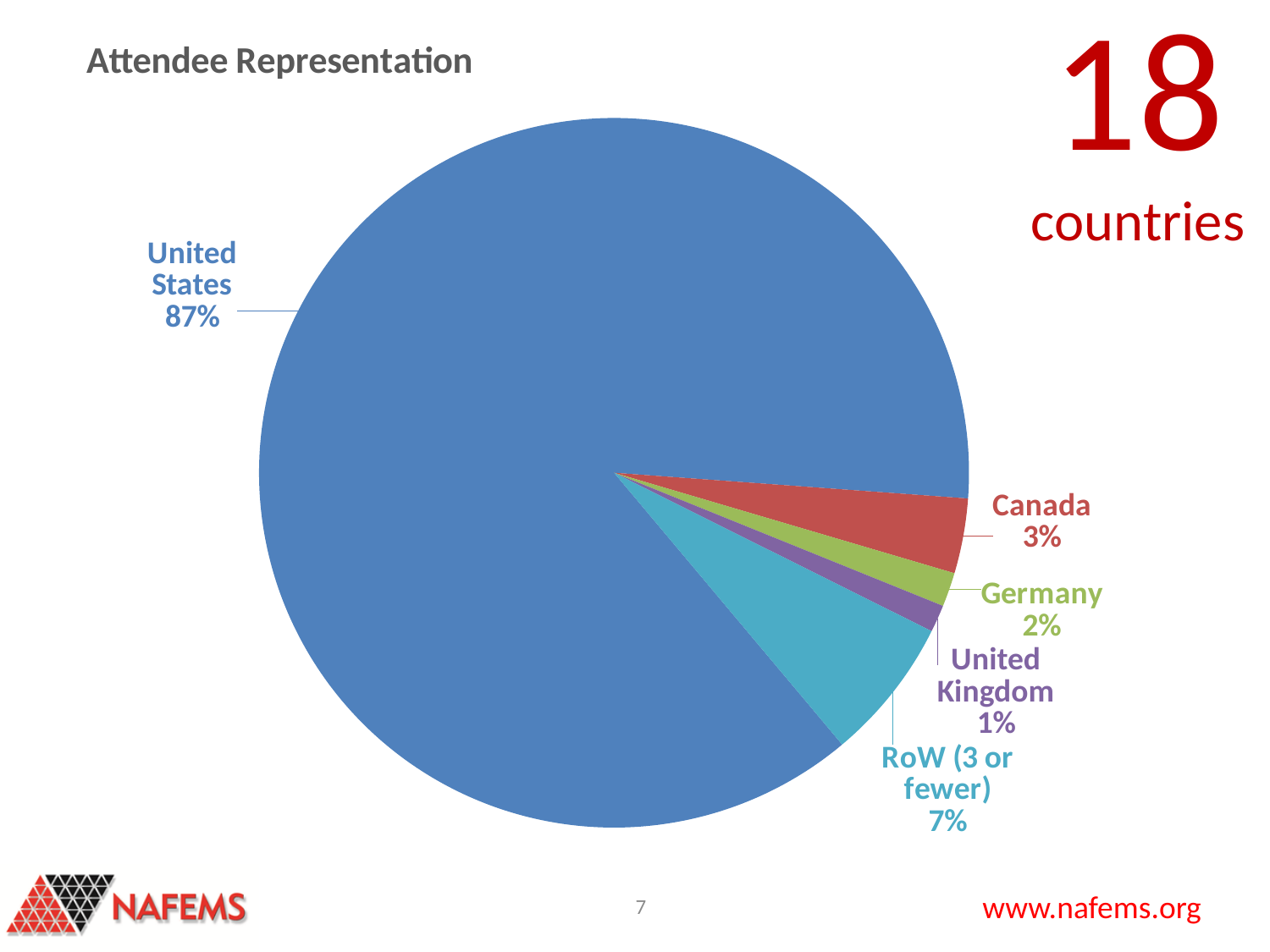
How many slices does the pie chart have? 5 What share of attendees is from Germany? 2% What share of attendees is from the United Kingdom? 1% What is the title of the chart? Attendee Representation Which slice of the pie is the smallest? United Kingdom What is the difference in percentage points between the United States and RoW (3 or fewer) slices? 80 What share of attendees is from Canada? 3% Which is larger, the Canada slice or the Germany slice? Canada What type of chart is shown on the slide? pie chart What share of attendees is from the United States? 87% Which slice of the pie is the largest? United States What share of attendees is in the RoW (3 or fewer) slice? 7%